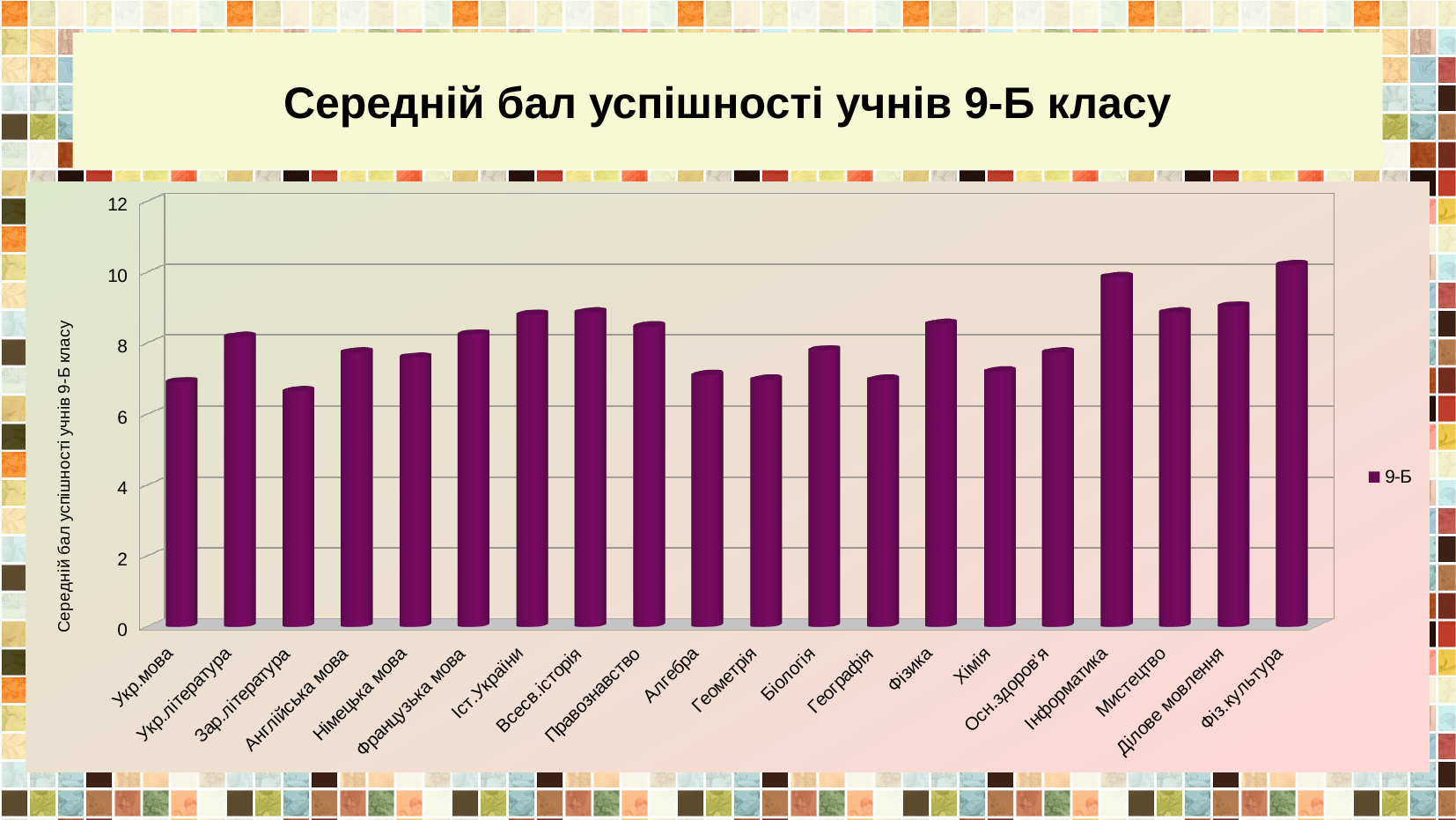
Which subject has the highest average score? Фіз.культура What is the name of the series shown in the legend? 9-Б Which subject has the lowest average score? Зар.література Which is larger, the value for Інформатика or the value for Алгебра? Інформатика What is the title of the chart? Середній бал успішності учнів 9-Б класу What kind of chart is shown on the slide? bar chart Is the value for Геометрія greater or less than 6? greater Is the value for Зар.література greater or less than 8? less Which is larger, the value for Всесв.історія or the value for Хімія? Всесв.історія How many series does the legend list? 1 How many subjects (categories) are plotted on the x axis? 20 Is the value for Інформатика greater or less than 8? greater